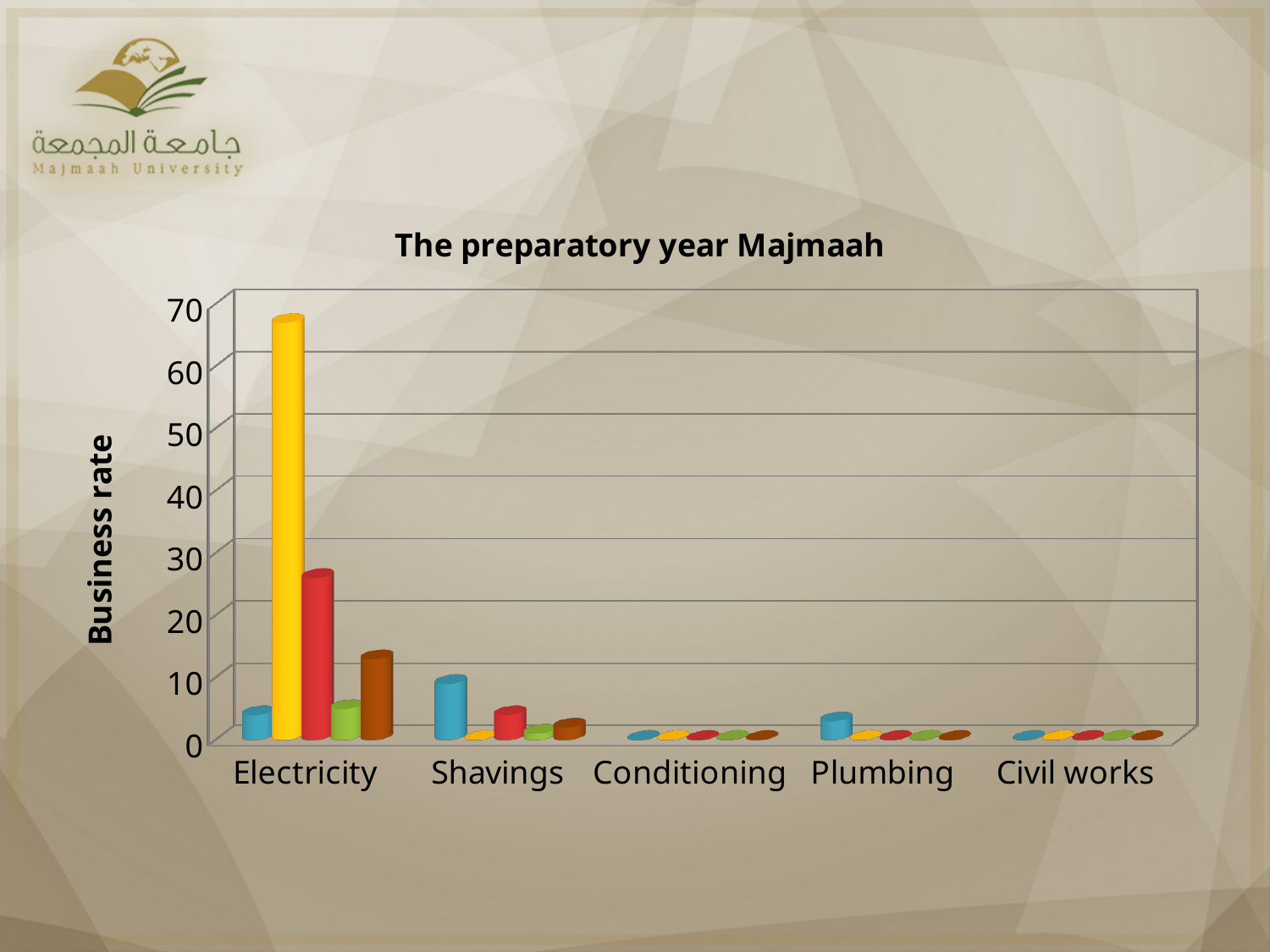
Is the value of the red bar for Electricity greater or less than 30? less Which is larger for Electricity, the yellow bar or the red bar? the yellow bar How many categories are shown on the x axis of the chart? 5 Is the value of the brown bar for Electricity greater or less than 10? greater How many bars are plotted for each category in the chart? 5 What is the label on the vertical axis of the chart? Business rate What kind of chart is shown on the slide? bar chart Which category has the tallest bar in the chart? Electricity Which category has the larger blue bar, Electricity or Shavings? Shavings What is the title of the chart? The preparatory year Majmaah Is the value of the yellow bar for Electricity greater or less than 60? greater